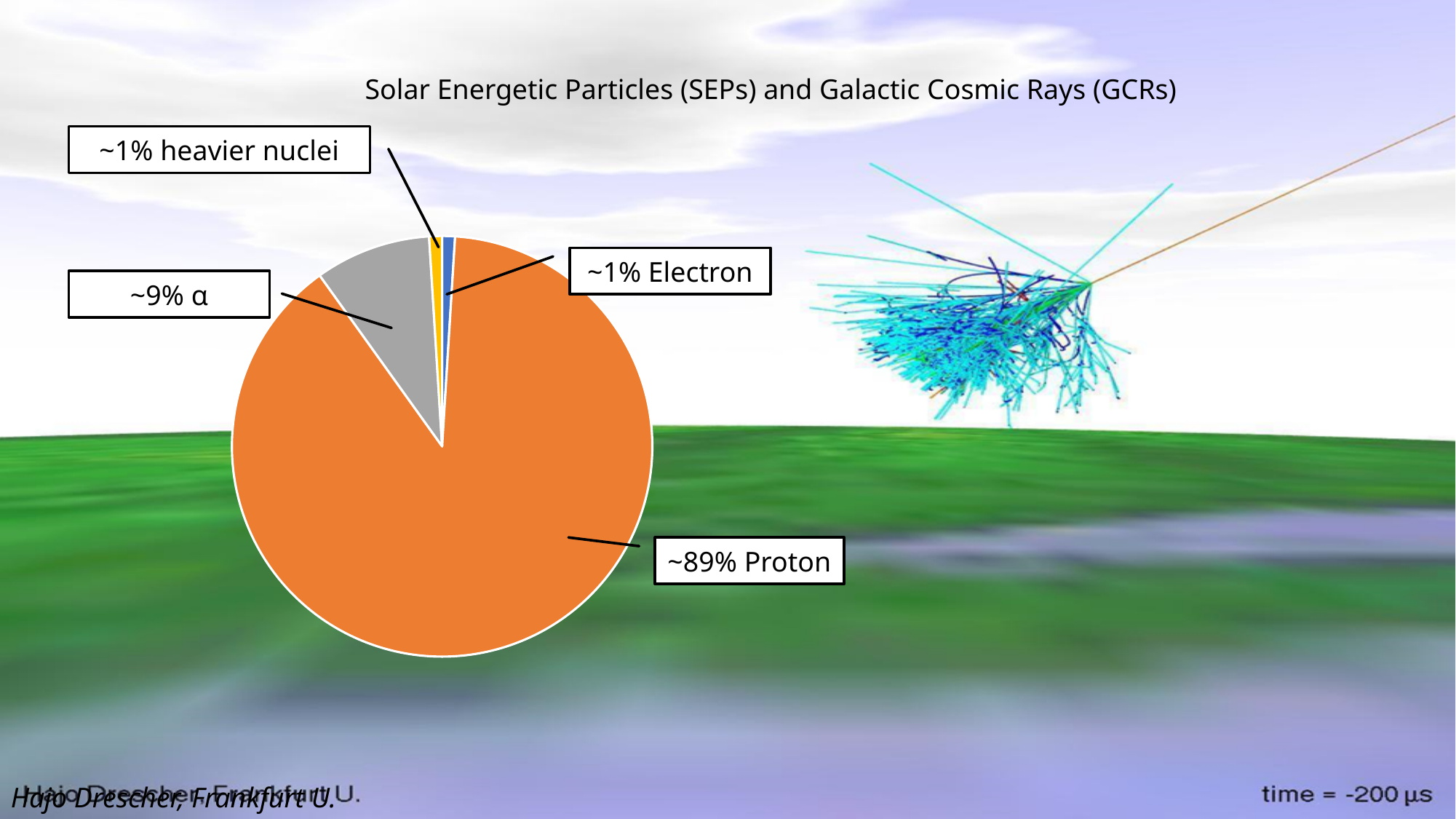
What share of the pie is labelled for Electron? ~1% What share of the pie is labelled for Proton? ~89% What kind of chart is shown on the slide? pie chart What colour is the Proton slice of the pie chart? orange What share of the pie is labelled for heavier nuclei? ~1% Which slice is larger, Proton or α? Proton Which slice is larger, α or Electron? α How many slices does the pie chart have? 4 Which particle type has the largest slice of the pie chart? Proton